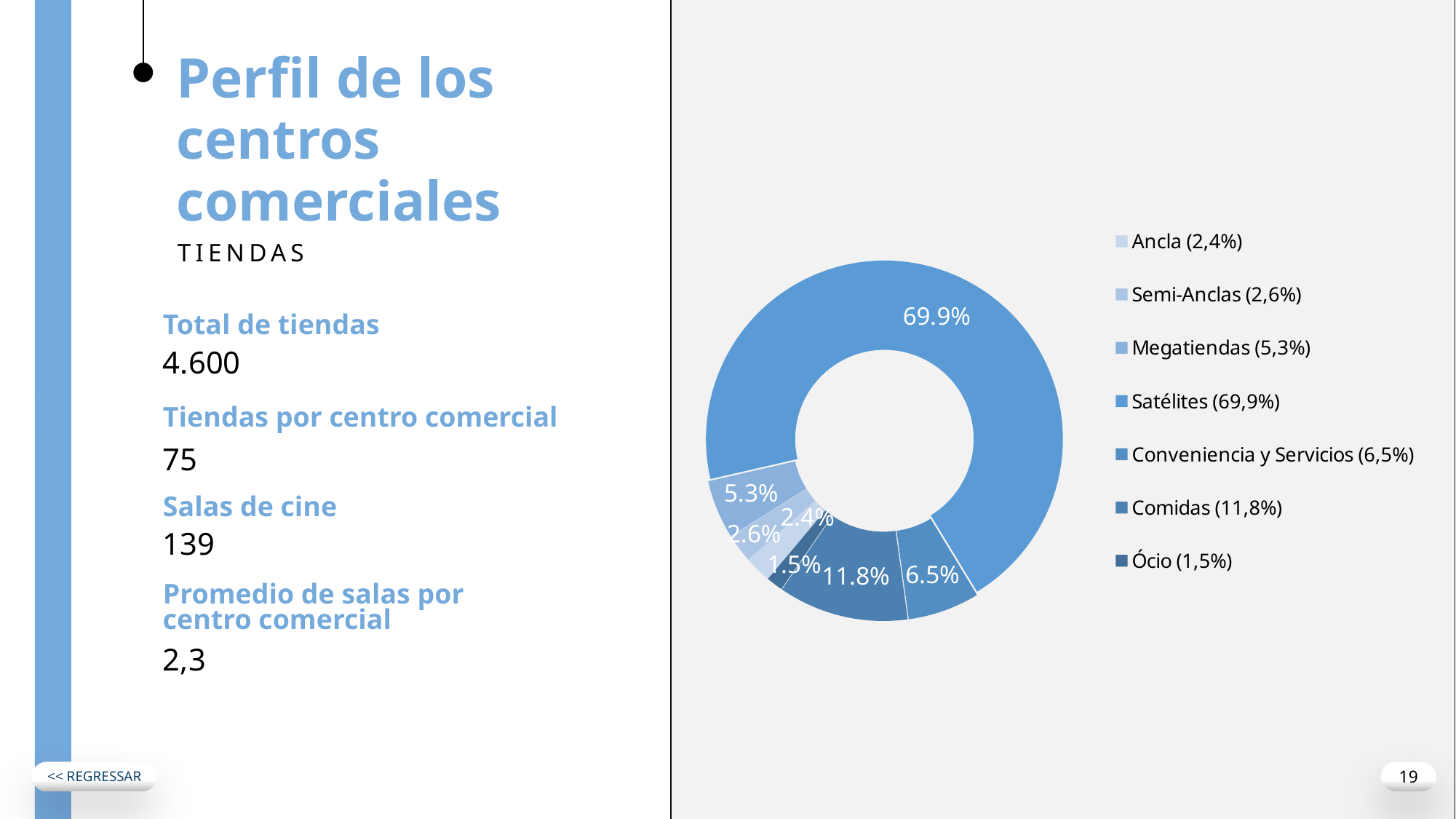
Which category has the largest share of the doughnut chart? Satélites What percentage of stores are Comidas? 11.8% What is the combined share of Ancla and Semi-Anclas? 5.0% Which category has the smallest share of the doughnut chart? Ócio How many categories does the doughnut chart show? 7 Which category is listed first in the chart legend? Ancla (2,4%) Which is larger, the share for Ancla or the share for Semi-Anclas? Semi-Anclas What kind of chart is shown on the slide? Doughnut (pie) chart What is the difference in percentage points between Comidas and Conveniencia y Servicios? 5.3 What percentage of stores are Conveniencia y Servicios? 6.5% What percentage of stores are Satélites? 69.9% What percentage of stores are Megatiendas? 5.3%